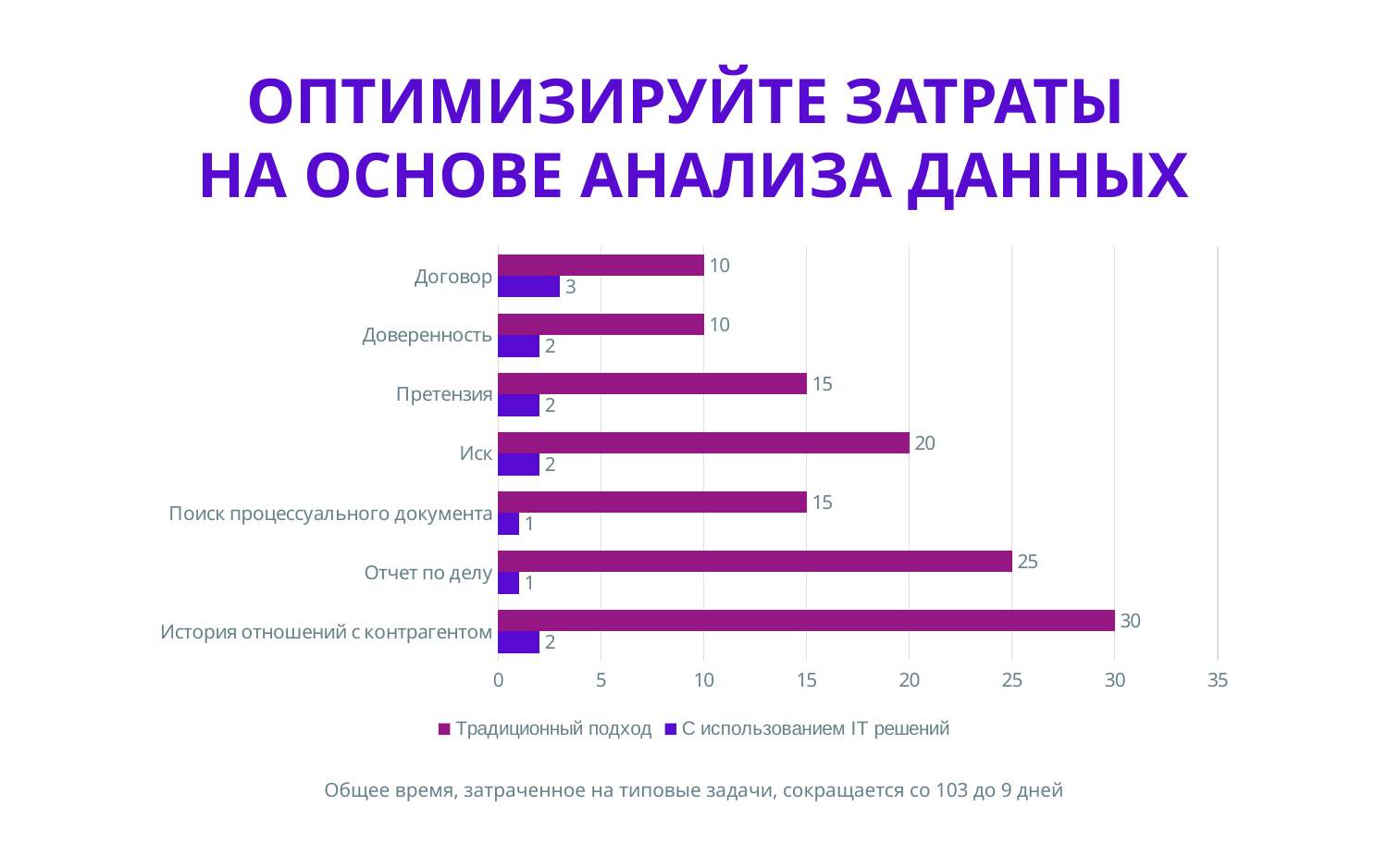
What kind of chart is shown on the slide? Bar chart What are the two series listed in the legend? Традиционный подход; С использованием IT решений How many categories are shown on the chart? 7 Which is larger: the Традиционный подход value for Претензия or for Иск? Иск Which category has the highest value in the С использованием IT решений series? Договор What is the value for Отчет по делу in the Традиционный подход series? 25 What is the difference between the Традиционный подход values for Отчет по делу and Договор? 15 What is the value for Иск in the Традиционный подход series? 20 Which category has the highest value in the Традиционный подход series? История отношений с контрагентом How many series does the legend list? 2 What is the value for Договор in the С использованием IT решений series? 3 What is the difference between the Традиционный подход and С использованием IT решений values for История отношений с контрагентом? 28